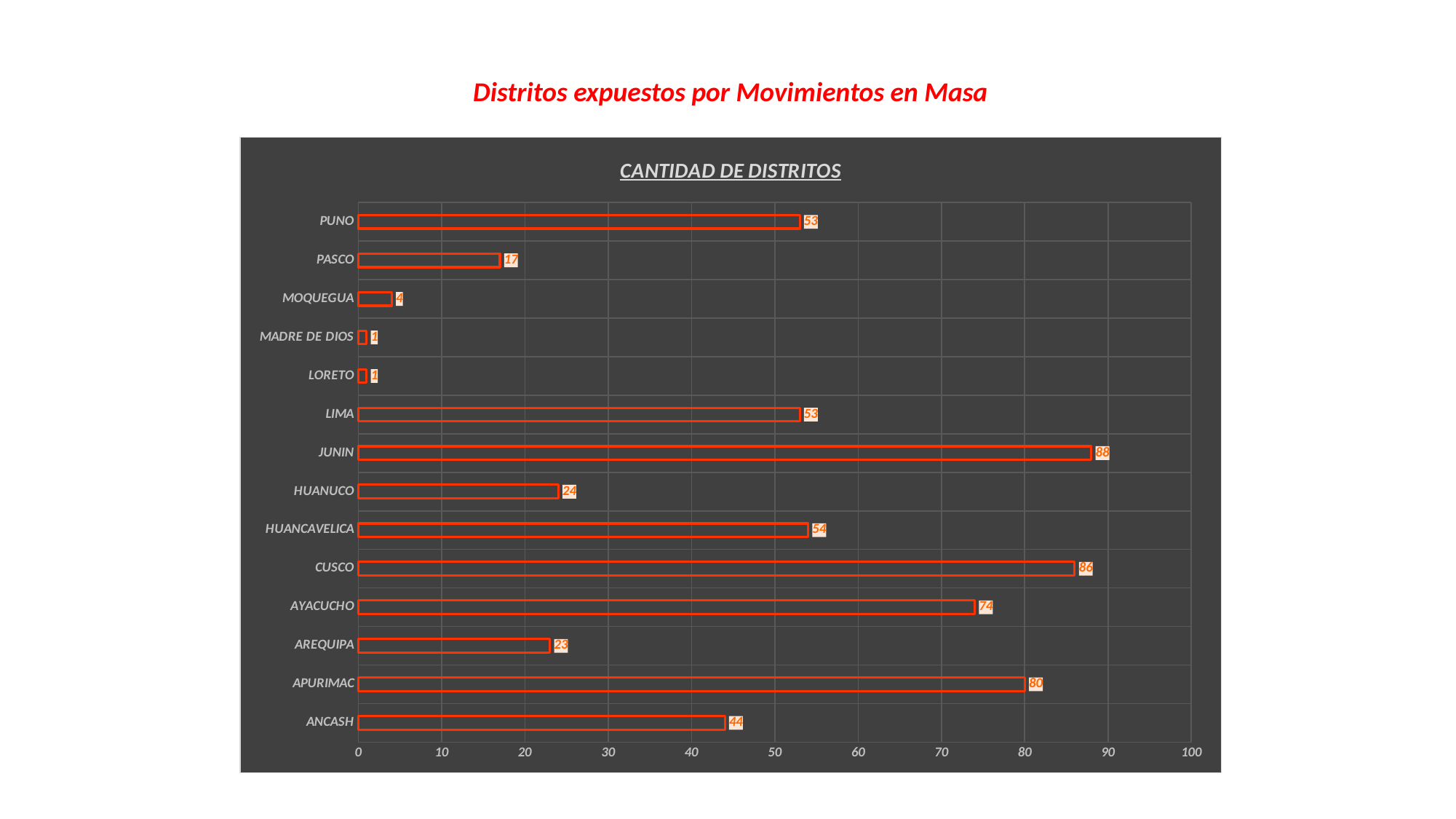
What is the value for HUANCAVELICA? 54 What is the difference between the values for PUNO and PASCO? 36 Which category has the highest value? JUNIN What is the title of the chart? CANTIDAD DE DISTRITOS What is the value for MOQUEGUA? 4 How many categories are shown on the chart? 14 Is the value for PASCO greater or less than 20? less What is the value for JUNIN? 88 What is the value for ANCASH? 44 What is the difference between the values for CUSCO and AYACUCHO? 12 What kind of chart is shown on the slide? bar chart Which is larger, the value for APURIMAC or the value for AYACUCHO? APURIMAC